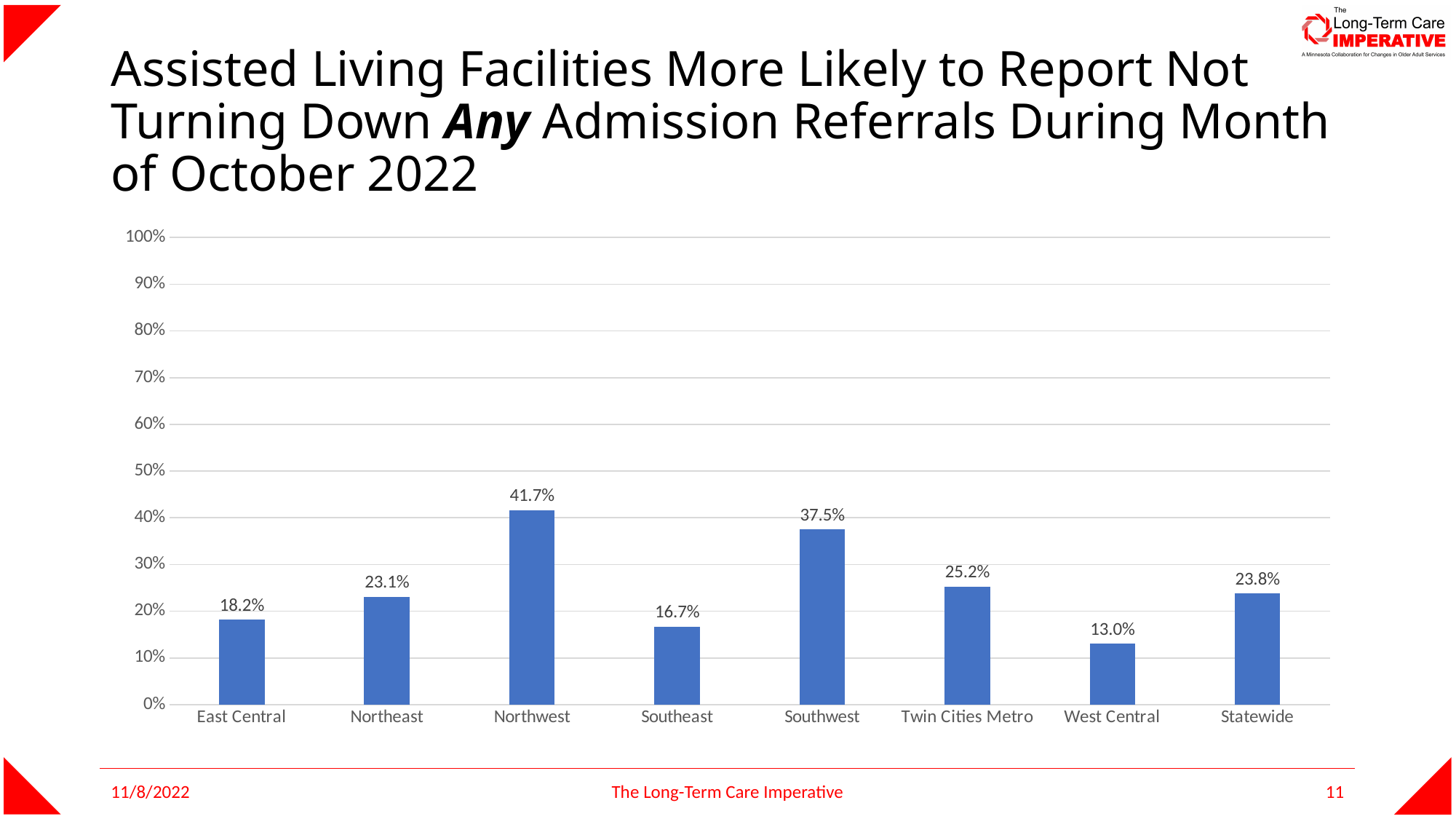
Which is larger, the value for East Central or the value for Northeast? Northeast Which region has the highest value? Northwest What is the value for Northwest? 41.7% What kind of chart is shown on the slide? Bar chart Is the value for Southwest greater or less than 30%? greater What is the difference between the Northeast and Southeast values? 6.4% What is the Statewide value? 23.8% What is the value for West Central? 13.0% What is the difference between the Northwest and Southwest values? 4.2% How many categories are shown on the x axis? 8 Which region has the lowest value? West Central What is the value for Twin Cities Metro? 25.2%